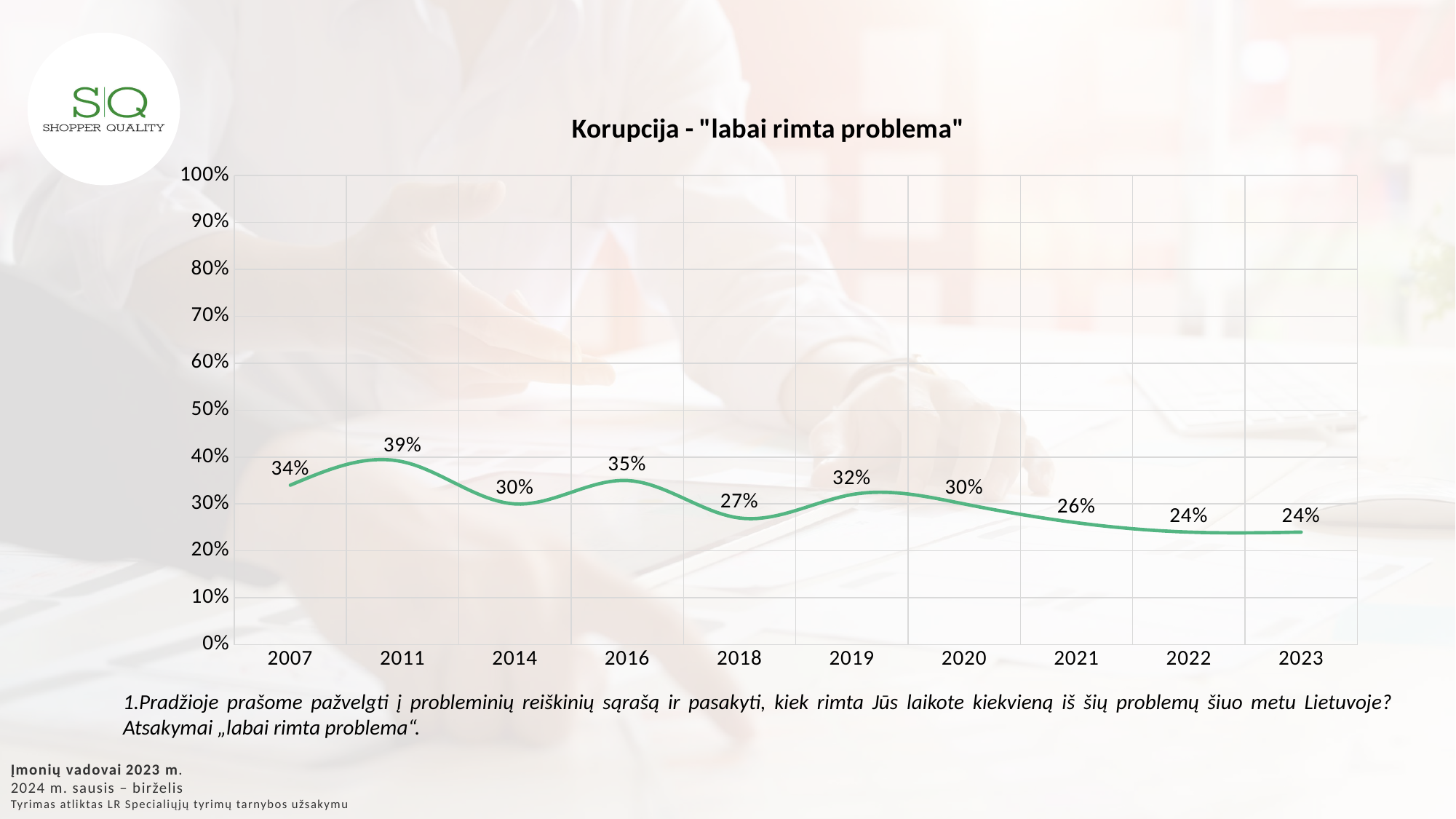
What is the value for 2007? 34% What is the lowest value shown on the chart? 24% Do the values rise or fall from 2019 to 2023? fall How many years are plotted on the chart? 10 What is the value for 2018? 27% What is the title of the chart? Korupcija - "labai rimta problema" Which year has the highest value? 2011 What kind of chart is shown? line chart Is the value for 2011 greater or less than 30%? greater Which is larger, the value for 2016 or the value for 2019? 2016 What is the value for 2021? 26% What is the difference between the values for 2011 and 2023? 15%